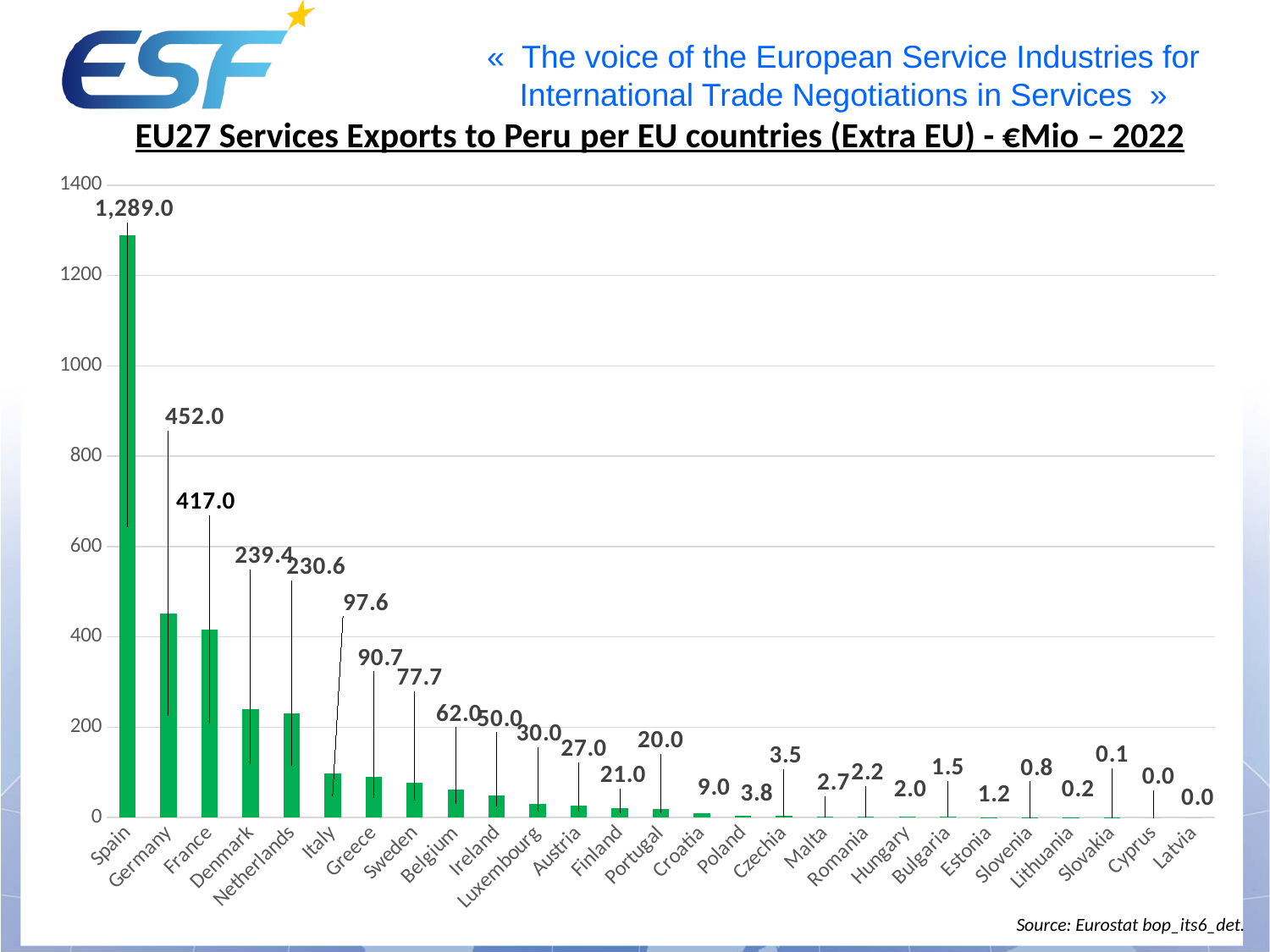
What is the difference between the values for Germany and France? 35.0 What is the difference between the values for Italy and Greece? 6.9 How many countries are shown on the x axis? 27 What kind of chart is shown on the slide? bar chart What is the value for Portugal? 20.0 What is the value for Spain? 1,289.0 Which country has the highest value? Spain What is the title of the chart? EU27 Services Exports to Peru per EU countries (Extra EU) - €Mio – 2022 Is the value for Spain greater or less than 1200? greater Which is larger, the value for Denmark or the value for the Netherlands? Denmark What is the value for Germany? 452.0 Do the values rise or fall from left to right along the x axis? fall